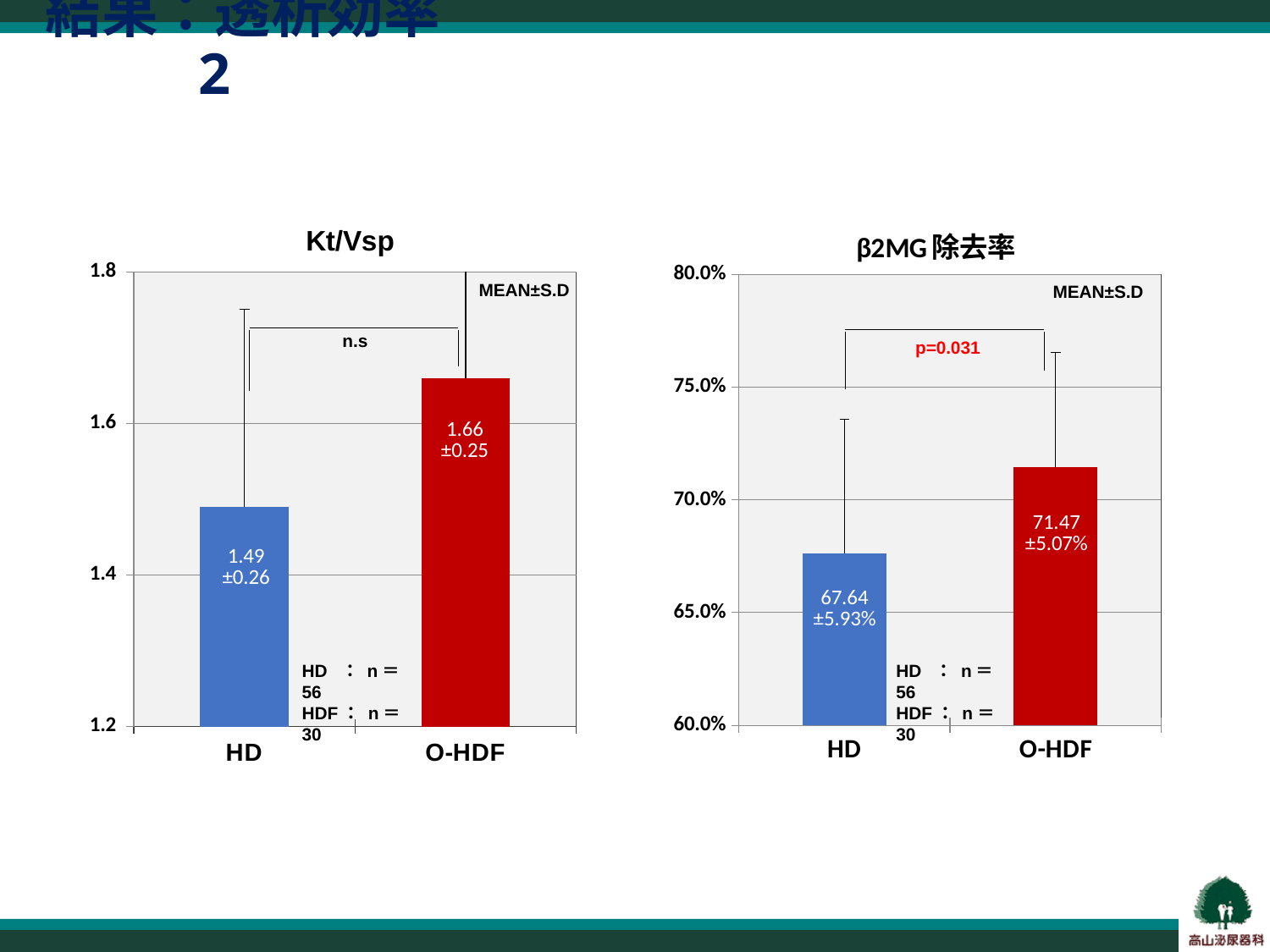
In the Kt/Vsp chart, what is the standard deviation shown for O-HDF? ±0.25 In the Kt/Vsp chart, what is the mean value for HD? 1.49 In the β2MG 除去率 chart, what is the mean value for O-HDF? 71.47 In the Kt/Vsp chart, what is the mean value for O-HDF? 1.66 In the Kt/Vsp chart, what is the difference between the O-HDF mean and the HD mean? 0.17 In the β2MG 除去率 chart, what is the difference between the O-HDF mean and the HD mean? 3.83 What type of chart is the Kt/Vsp chart? Bar chart In the Kt/Vsp chart, which category has the higher mean value, HD or O-HDF? O-HDF In the Kt/Vsp chart, what significance result is shown between HD and O-HDF? n.s In the β2MG 除去率 chart, which category has the lower mean value? HD In the β2MG 除去率 chart, what is the standard deviation shown for HD? ±5.93% In the β2MG 除去率 chart, what is the mean value for HD? 67.64